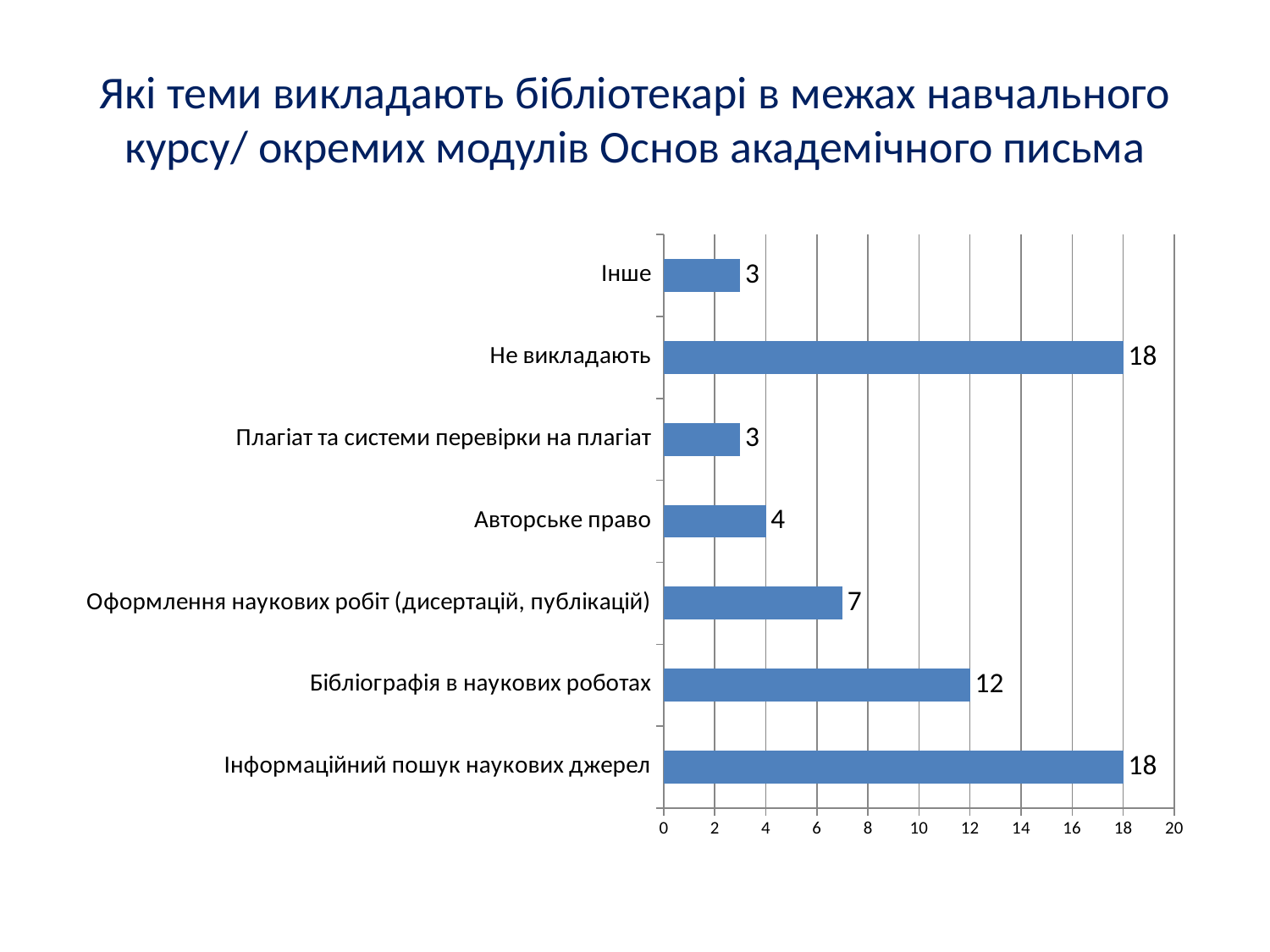
What is the difference between the values for "Інформаційний пошук наукових джерел" and "Плагіат та системи перевірки на плагіат"? 15 How many categories are shown in the chart? 7 What is the value for "Не викладають"? 18 What is the value for "Бібліографія в наукових роботах"? 12 What is the value for "Оформлення наукових робіт (дисертацій, публікацій)"? 7 Which category has the lowest value, "Авторське право" or "Інше"? Інше Which is larger, the value for "Бібліографія в наукових роботах" or the value for "Оформлення наукових робіт (дисертацій, публікацій)"? Бібліографія в наукових роботах Is the value for "Бібліографія в наукових роботах" greater or less than 10? greater What kind of chart is shown on the slide? bar chart What is the difference between the values for "Бібліографія в наукових роботах" and "Оформлення наукових робіт (дисертацій, публікацій)"? 5 What is the value for "Авторське право"? 4 What is the maximum value shown on the horizontal axis? 20